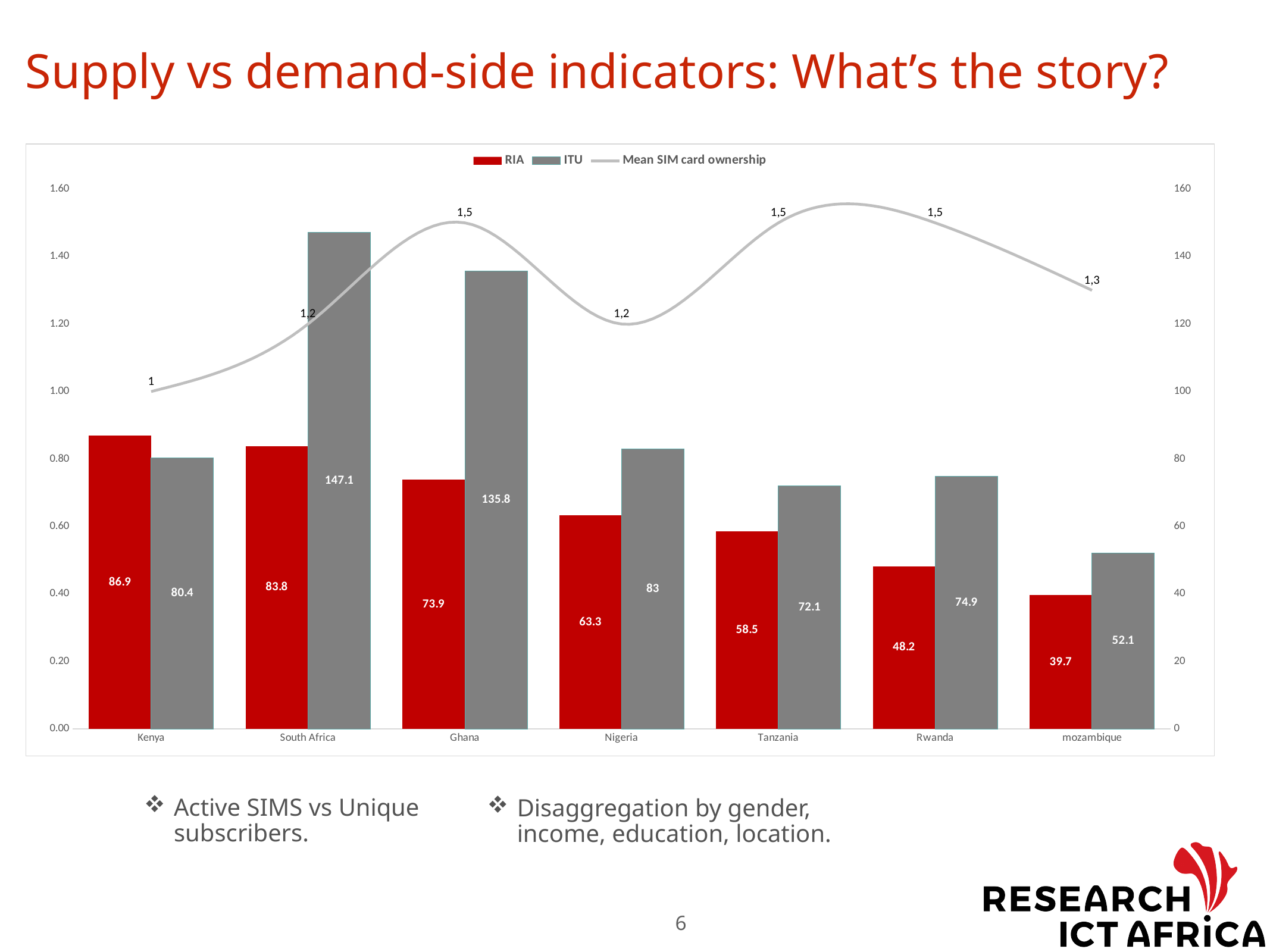
What colour are the RIA bars? Red What is the difference between the ITU and RIA values for Ghana? 61.9 What kind of chart is this? Combined bar and line chart Which is larger for Kenya, the RIA value or the ITU value? RIA Which country has the lowest RIA value? mozambique Do the RIA values rise or fall from Kenya to mozambique? Fall How many countries are shown on the x axis? 7 How many series does the legend list? 3 What is the RIA value for Kenya? 86.9 What is the Mean SIM card ownership value for Ghana? 1,5 Which country has the highest ITU value? South Africa What is the ITU value for South Africa? 147.1